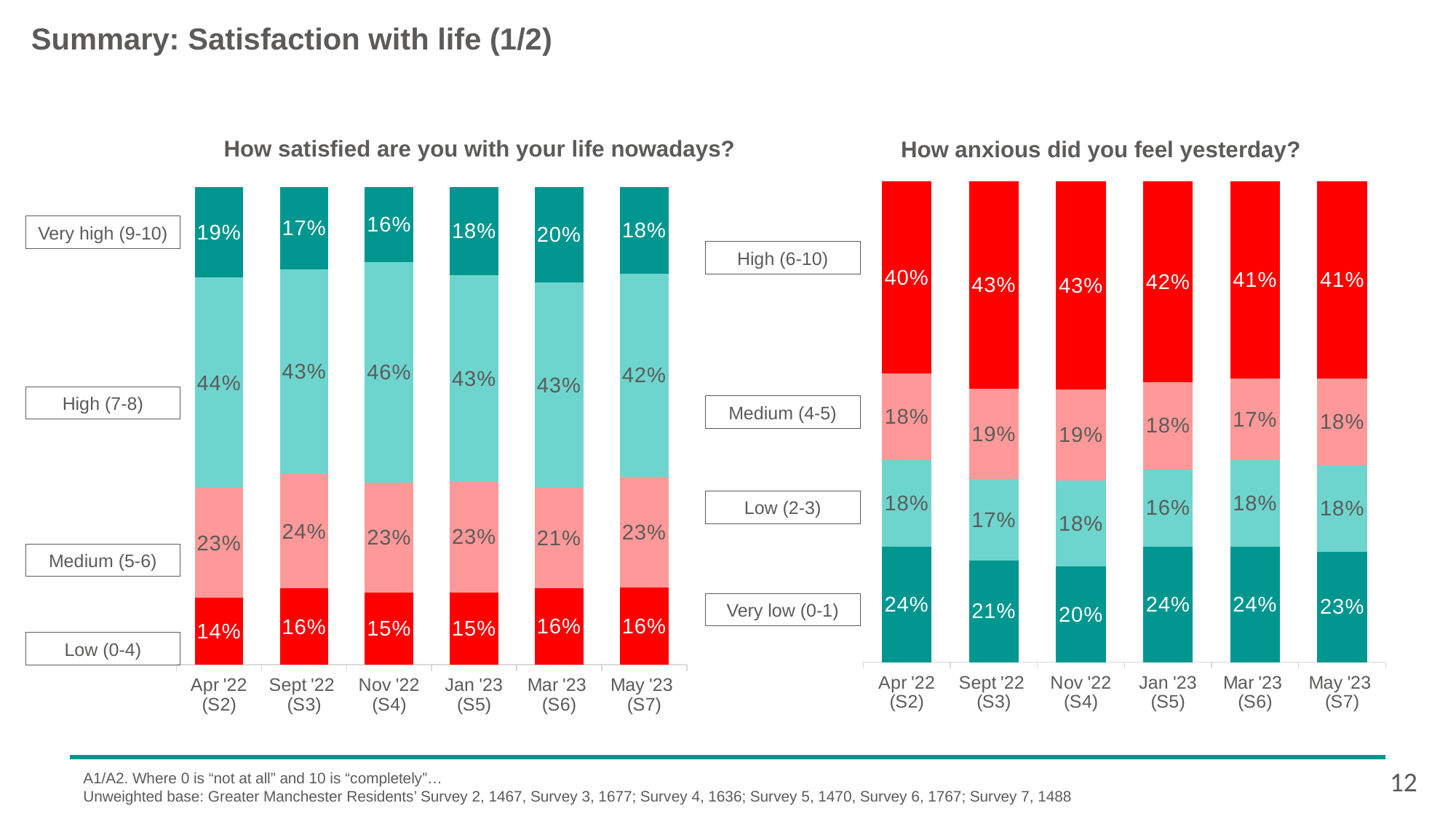
In the chart 'How satisfied are you with your life nowadays?', which survey wave has the highest High (7-8) percentage? Nov '22 (S4) In the chart 'How anxious did you feel yesterday?', what percentage gave a Very low (0-1) rating in Nov '22 (S4)? 20% In the chart 'How anxious did you feel yesterday?', which survey wave has the lowest High (6-10) percentage? Apr '22 (S2) In the chart 'How satisfied are you with your life nowadays?', what percentage gave a Low (0-4) rating in Apr '22 (S2)? 14% What type of chart is 'How satisfied are you with your life nowadays?'? Stacked bar chart How many survey waves are shown on the x axis of the chart 'How anxious did you feel yesterday?'? 6 In the chart 'How anxious did you feel yesterday?', what percentage gave a High (6-10) rating in Sept '22 (S3)? 43% In the chart 'How anxious did you feel yesterday?', is the Very low (0-1) percentage larger in Apr '22 (S2) or in Sept '22 (S3)? Apr '22 (S2) How many rating categories are stacked in each bar of the chart 'How satisfied are you with your life nowadays?'? 4 In the chart 'How satisfied are you with your life nowadays?', what is the difference between the High (7-8) percentage in Nov '22 (S4) and in May '23 (S7)? 4 percentage points In the chart 'How anxious did you feel yesterday?', what colour is the High (6-10) segment? Red In the chart 'How satisfied are you with your life nowadays?', what percentage gave a Very high (9-10) rating in Mar '23 (S6)? 20%